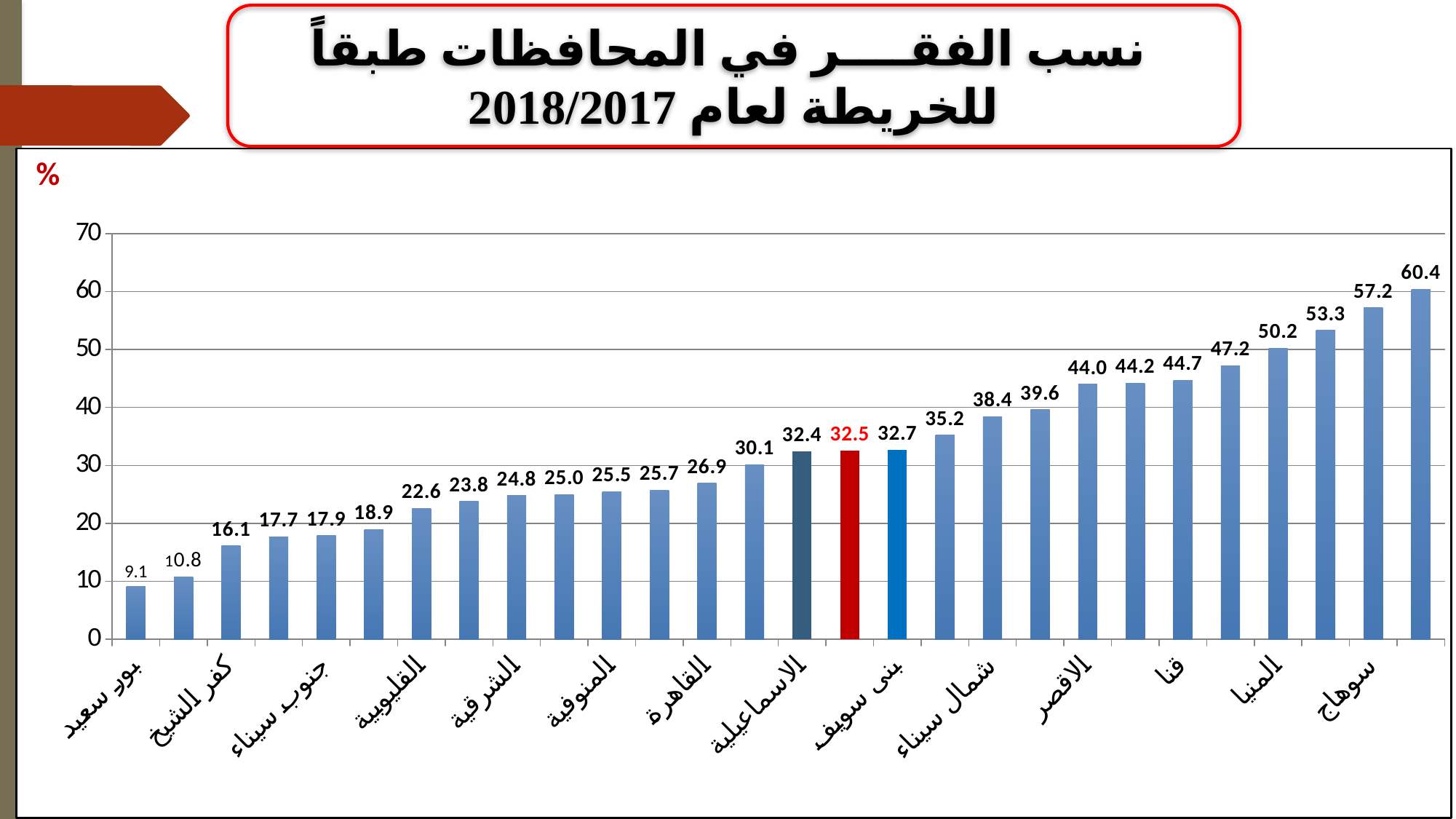
What is the value shown for سوهاج? 57.2 How many bars are plotted in the chart? 28 Is the value for كفر الشيخ greater or less than 20? less Which has the higher value, سوهاج or المنيا? سوهاج What is the difference between the values for سوهاج and بور سعيد? 48.1 Do the values rise or fall from left to right along the x axis? rise What is the value shown for المنيا? 50.2 What kind of chart is shown on the slide? bar chart What is the value of the red bar in the chart? 32.5 What is the poverty rate shown for بور سعيد? 9.1 What is the value shown for القاهرة? 26.9 Which labelled governorate has the lowest poverty rate? بور سعيد